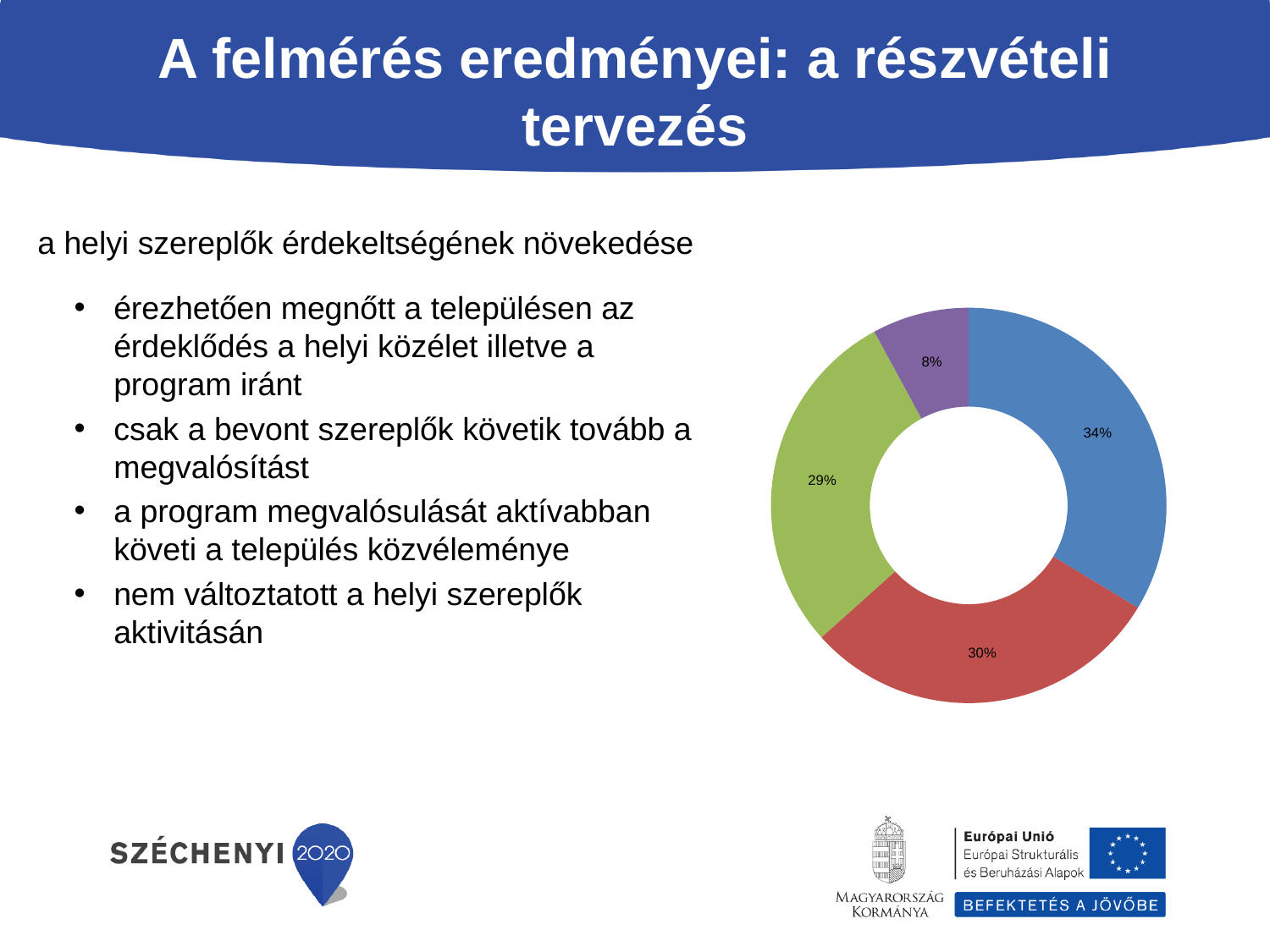
What is the difference between the red slice and the green slice in the doughnut chart? 1 percentage point What is the value of the smallest slice in the doughnut chart? 8% What kind of chart is shown on the slide? Doughnut (pie) chart How many slices does the doughnut chart have? 4 What percentage is shown on the green slice of the doughnut chart? 29% What colour is the smallest slice of the doughnut chart? Purple Which slice is larger in the doughnut chart, the blue one or the purple one? The blue one What percentage is shown on the red slice of the doughnut chart? 30% What percentage is shown on the purple slice of the doughnut chart? 8% What is the difference between the largest slice (34%) and the smallest slice (8%) in the doughnut chart? 26 percentage points What percentage is shown on the blue slice of the doughnut chart? 34% What is the value of the largest slice in the doughnut chart? 34%